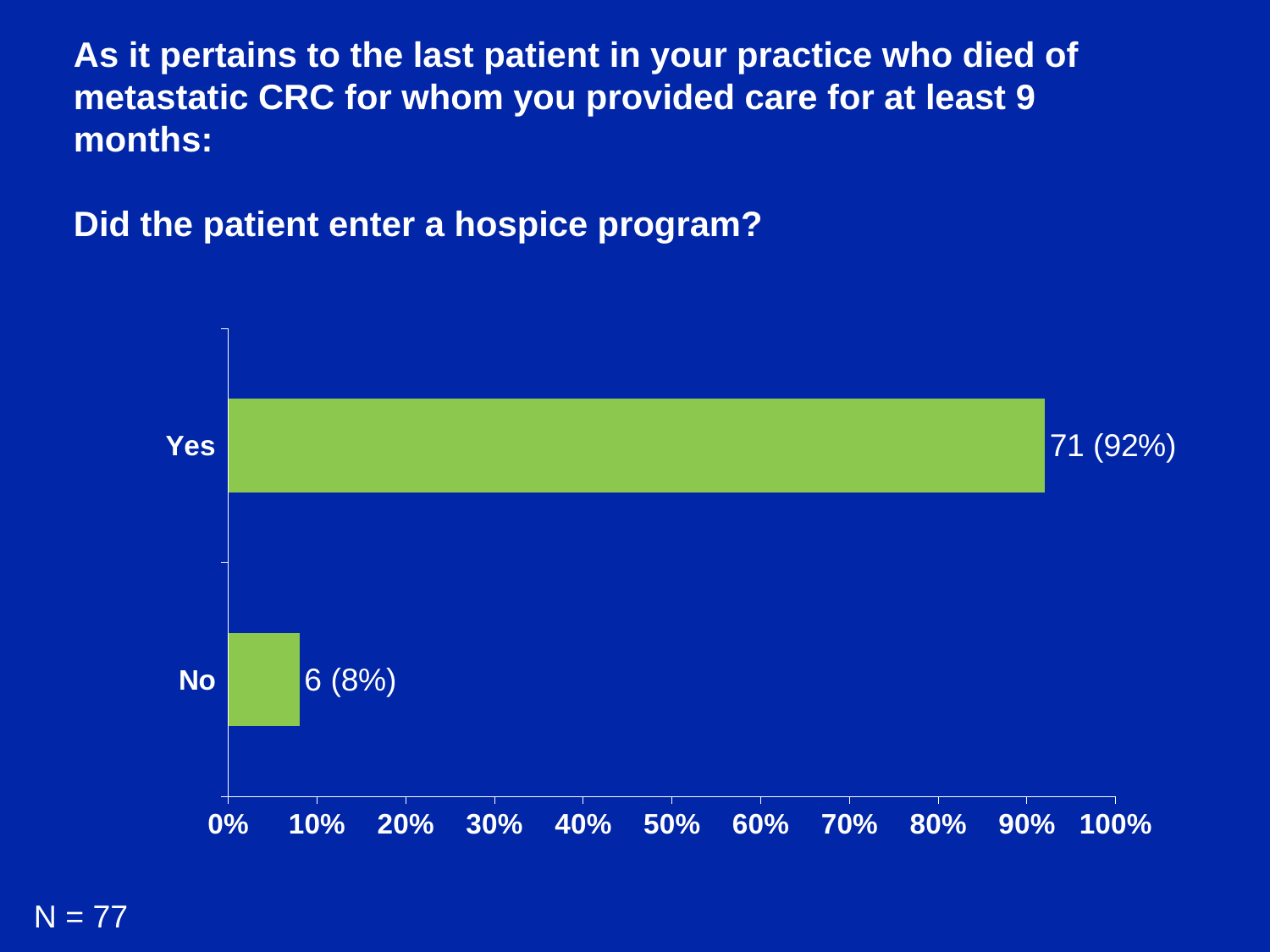
What is the data label shown for the "No" bar? 6 (8%) Is the value for "Yes" greater or less than 50%? greater Is the value for "No" greater or less than 10%? less What is the data label shown for the "Yes" bar? 71 (92%) Which is larger, the value for "Yes" or the value for "No"? Yes What is the difference in percentage points between the "Yes" and "No" bars? 84 Which category has the lowest value? No How many more respondents answered "Yes" than "No"? 65 Which category has the highest value? Yes How many categories are shown in the chart? 2 What kind of chart is shown on the slide? bar chart What is the sample size (N) stated on the slide? N = 77